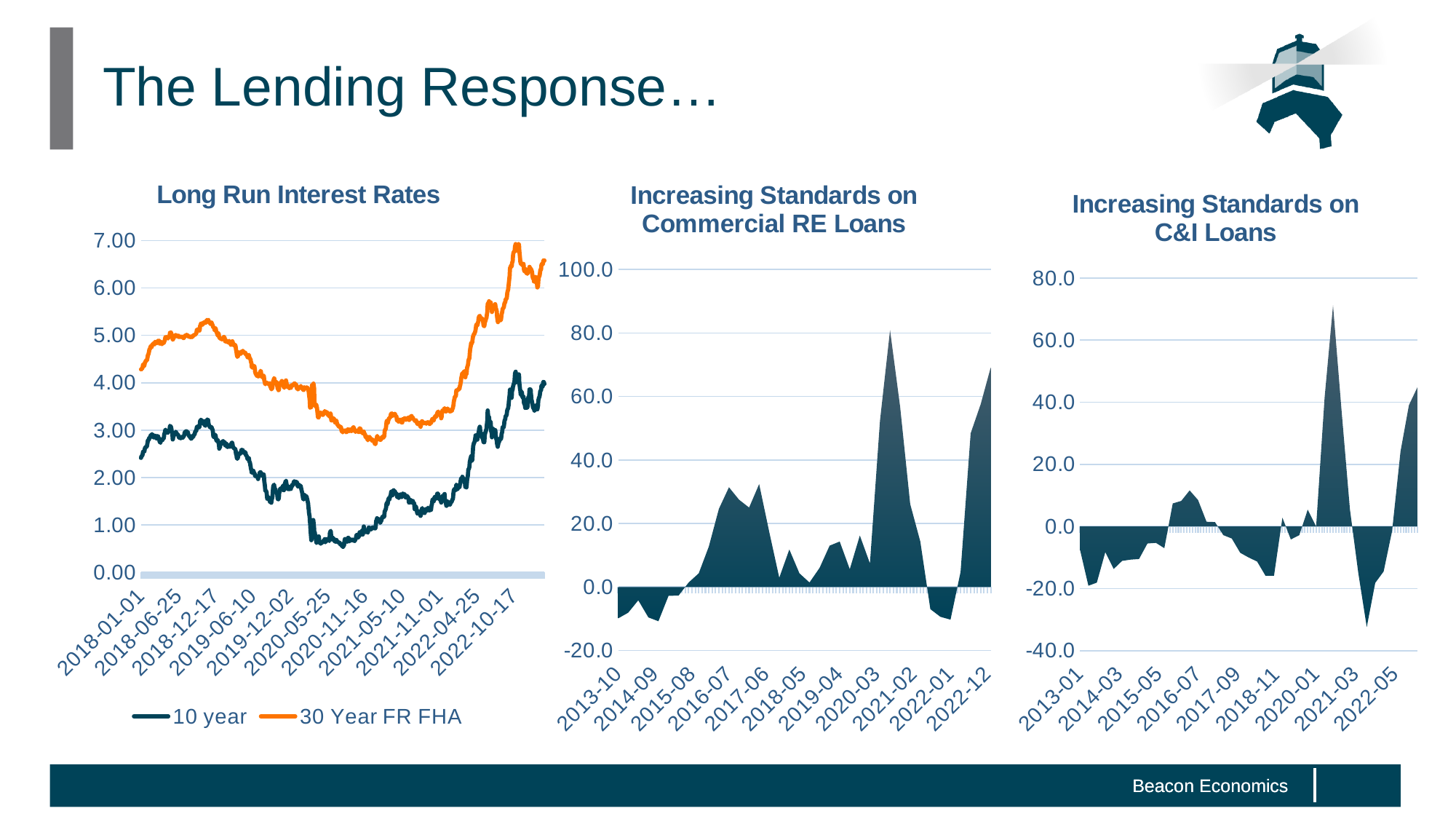
In the Increasing Standards on C&I Loans chart, is the highest peak greater or less than 60.0? greater In the Increasing Standards on C&I Loans chart, is the lowest value greater or less than -20.0? less In the Increasing Standards on Commercial RE Loans chart, is the peak value near 2021-02 greater or less than 60.0? greater In the Long Run Interest Rates chart, which series is higher throughout the period, 10 year or 30 Year FR FHA? 30 Year FR FHA In the Long Run Interest Rates chart, does the 10 year series rise or fall between 2020-05-25 and 2022-10-17? rise What kind of chart is the Long Run Interest Rates chart? line chart What kind of chart is the Increasing Standards on Commercial RE Loans chart? area chart How many series does the legend of the Long Run Interest Rates chart list? 2 What are the two series named in the legend of the Long Run Interest Rates chart? 10 year and 30 Year FR FHA